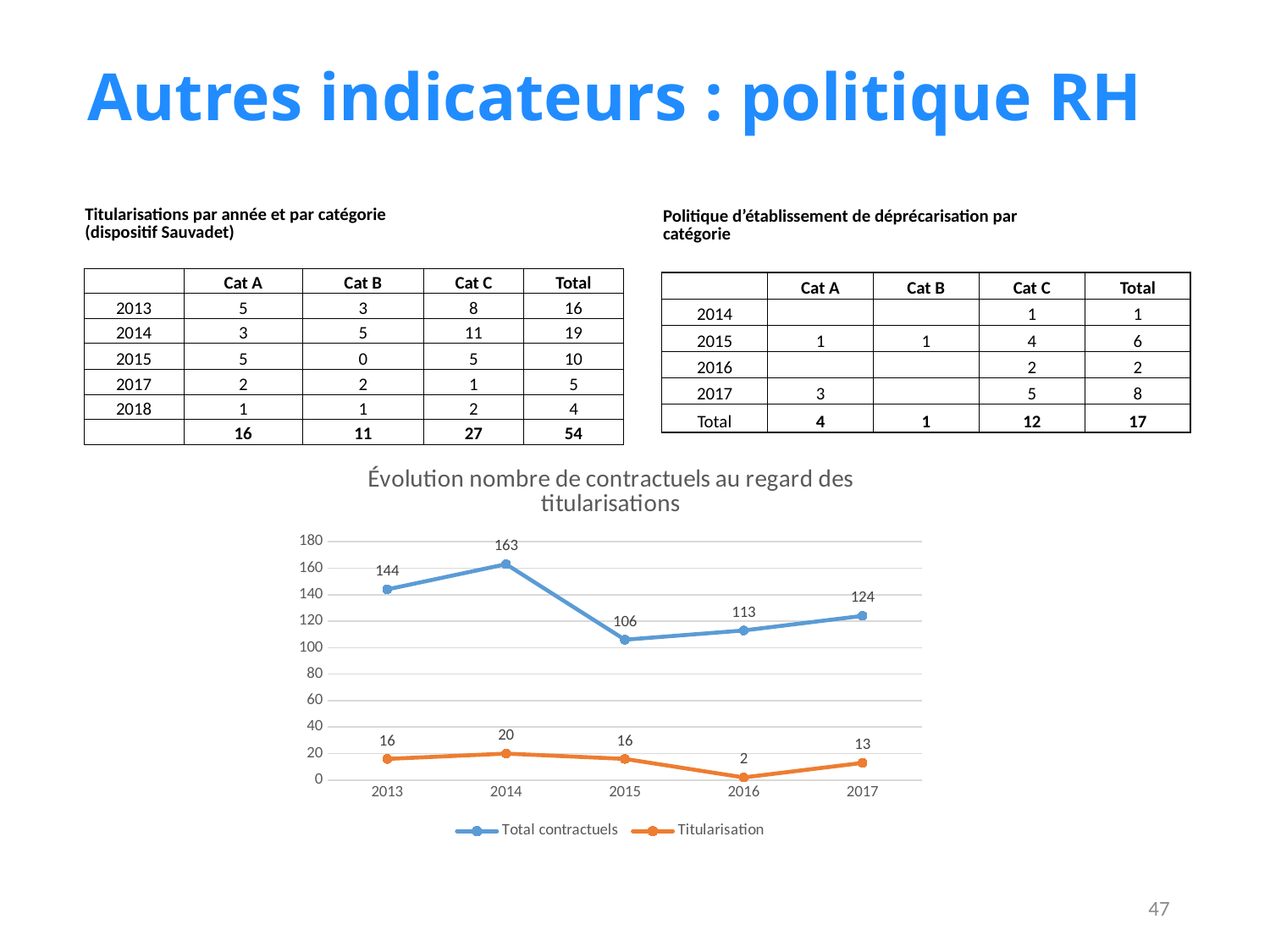
What is the value of Total contractuels in 2014? 163 What is the title of the chart? Évolution nombre de contractuels au regard des titularisations How many years are plotted on the x axis? 5 What is the difference between Total contractuels in 2014 and in 2015? 57 In which year is Titularisation lowest? 2016 How many series does the legend list? 2 What is the value of Total contractuels in 2017? 124 In which year is Total contractuels lowest? 2015 In which year is Total contractuels highest? 2014 What is the value of Titularisation in 2016? 2 Which is larger: Total contractuels in 2013 or in 2017? 2013 What type of chart is shown on the slide? line chart